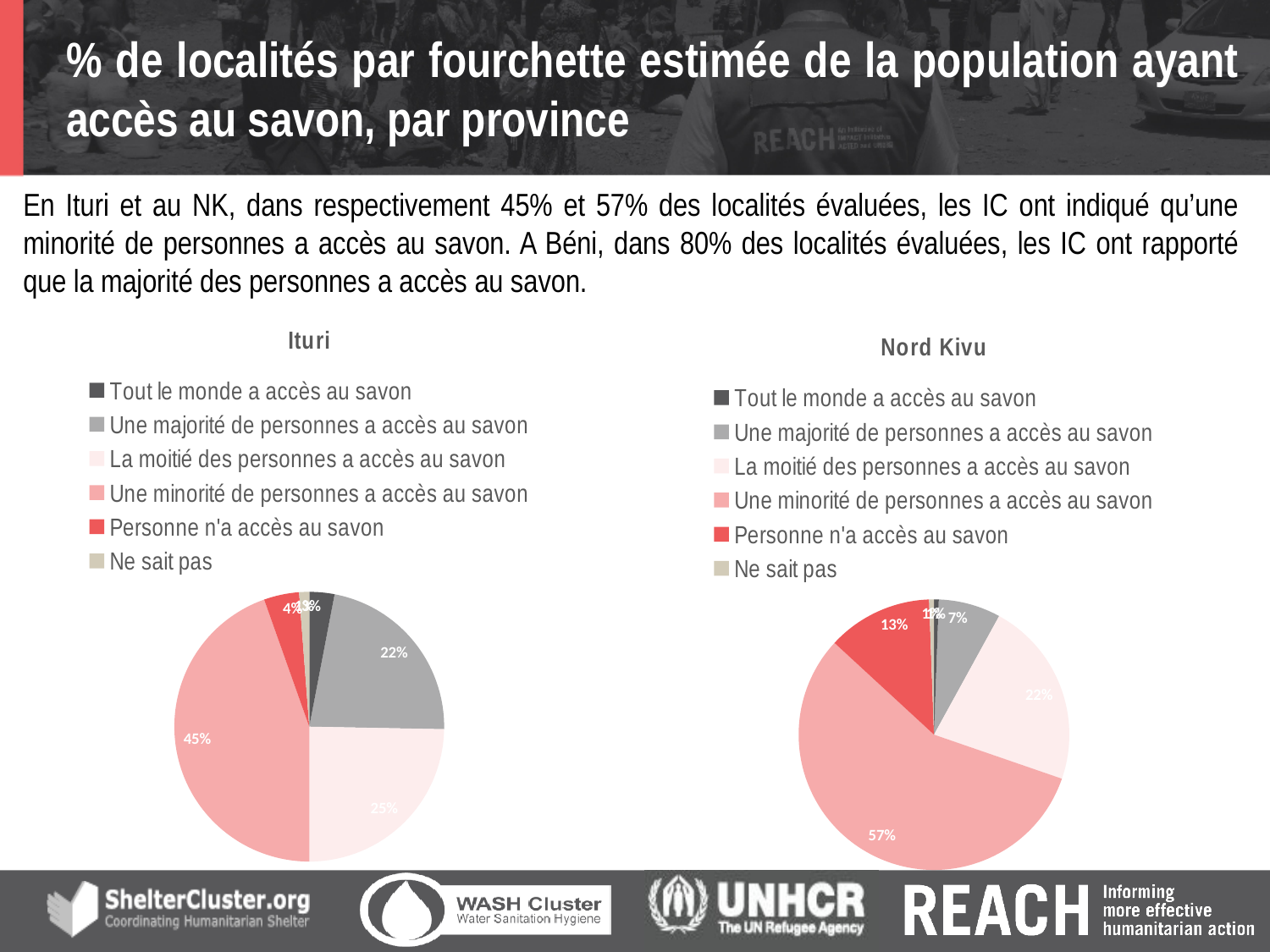
In the Nord Kivu pie chart, which category has the largest share? Une minorité de personnes a accès au savon In the Nord Kivu pie chart, what percentage corresponds to 'Personne n'a accès au savon'? 13% In the Nord Kivu pie chart, what percentage corresponds to 'Une majorité de personnes a accès au savon'? 7% In the Ituri pie chart, what percentage corresponds to 'Une majorité de personnes a accès au savon'? 22% In the Nord Kivu pie chart, what percentage corresponds to 'Une minorité de personnes a accès au savon'? 57% In the Ituri pie chart, what percentage of localities reported that a minority of people have access to soap (Une minorité de personnes a accès au savon)? 45% How many categories does the legend of the Nord Kivu chart list? 6 In the Ituri pie chart, which is larger: the share for 'La moitié des personnes a accès au savon' or for 'Une majorité de personnes a accès au savon'? La moitié des personnes a accès au savon In the Ituri pie chart, which category has the largest share? Une minorité de personnes a accès au savon What is the difference between the 'Une minorité de personnes a accès au savon' share in Nord Kivu and in Ituri? 12 percentage points What type of chart is used for Ituri and Nord Kivu on this slide? Pie chart In the Ituri pie chart, what percentage corresponds to 'La moitié des personnes a accès au savon'? 25%